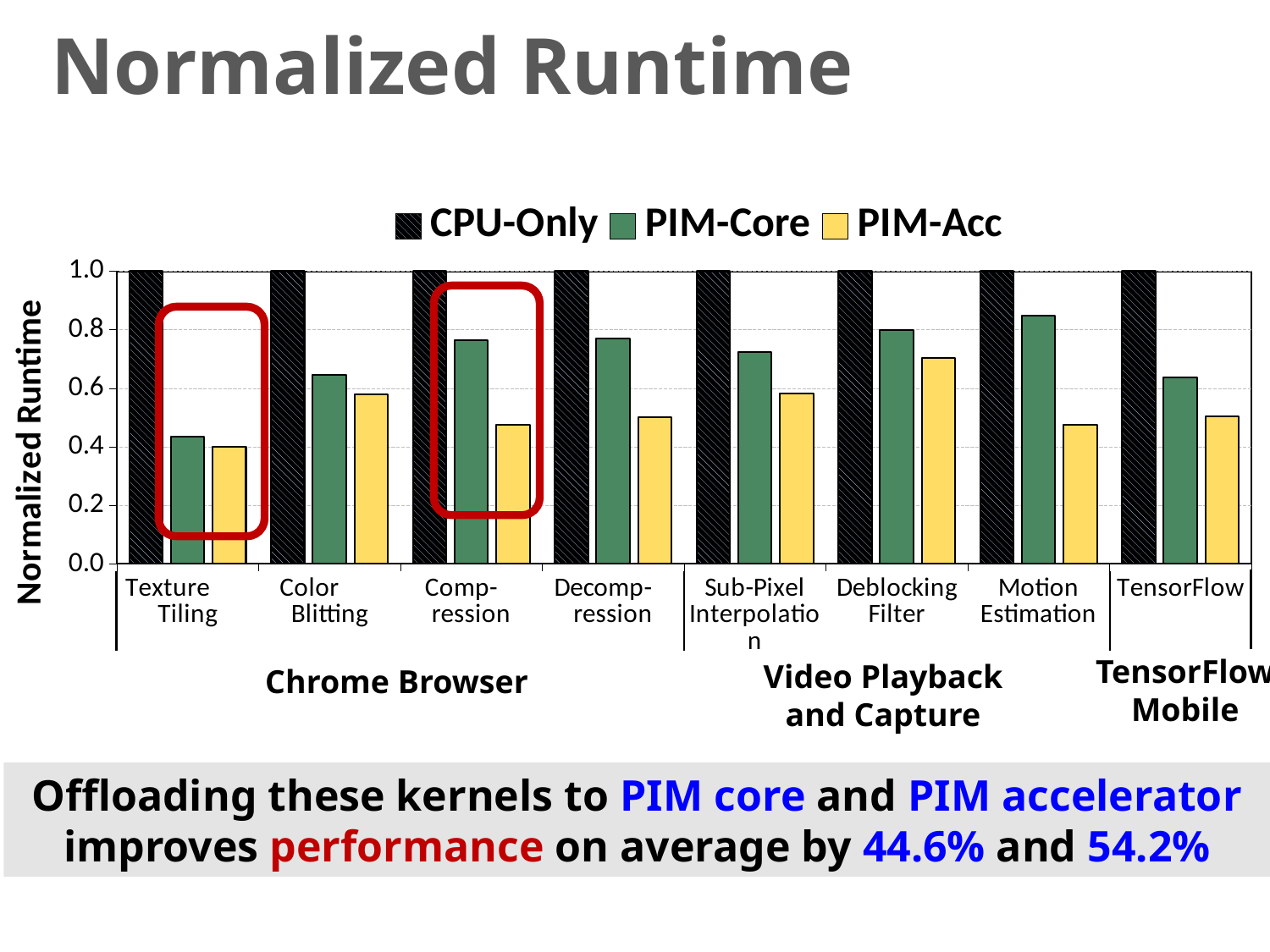
Which category has the lowest PIM-Acc normalized runtime? Texture Tiling Is the PIM-Acc value for Deblocking Filter greater or less than 0.6? greater What is the CPU-Only normalized runtime for Texture Tiling? 1.0 For Compression, which is larger: the PIM-Core value or the PIM-Acc value? PIM-Core Is the PIM-Core value for Color Blitting greater or less than 0.8? less What are the three series named in the legend? CPU-Only, PIM-Core, PIM-Acc How many series does the legend list? 3 Which category has the highest PIM-Core normalized runtime? Motion Estimation Is the PIM-Acc value for Texture Tiling greater or less than 0.6? less How many kernel categories are plotted along the x axis? 8 What kind of chart is shown on the slide? bar chart Which two categories are highlighted with red boxes on the chart? Texture Tiling and Compression